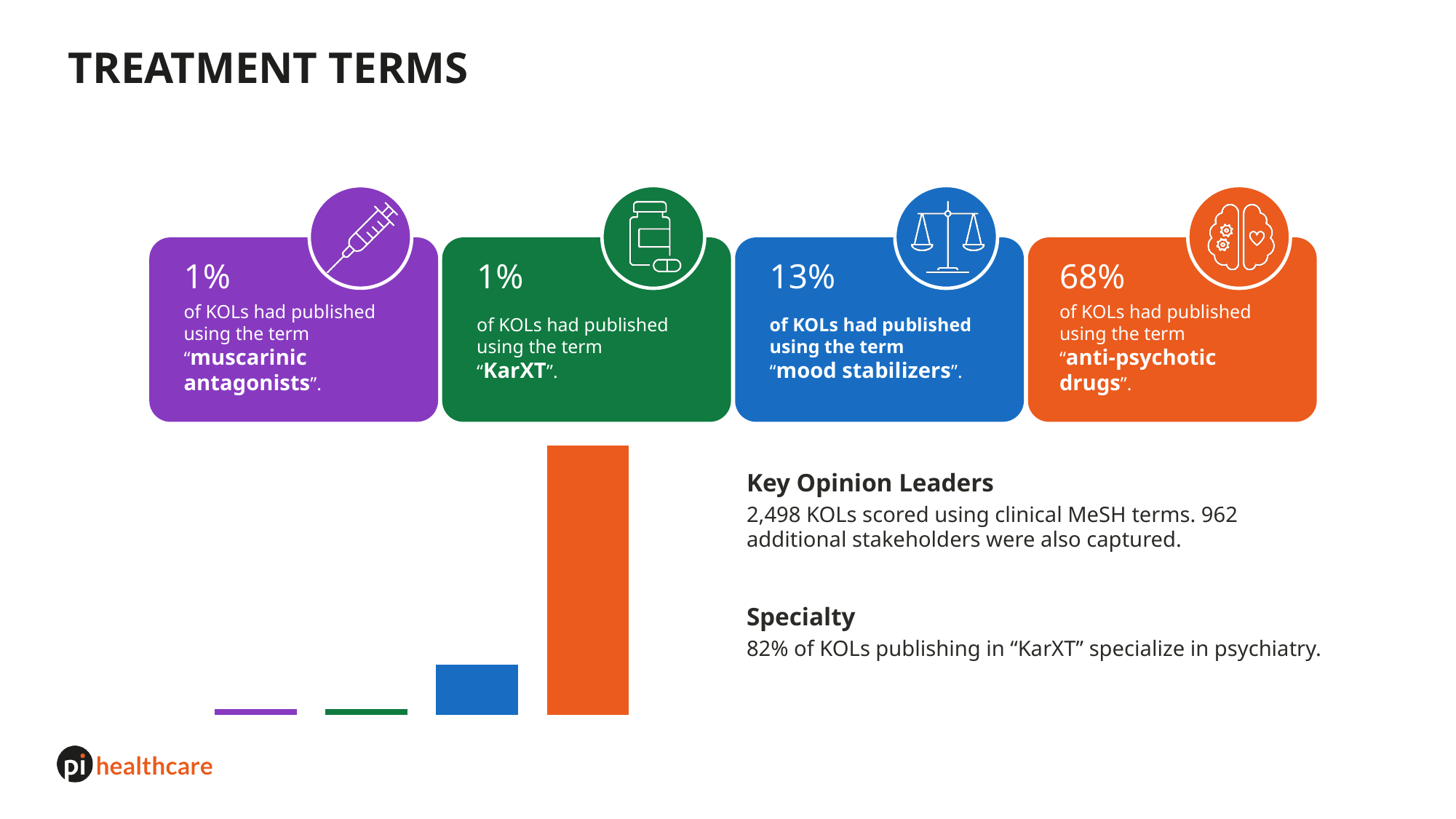
What colour is the bar representing "mood stabilizers"? blue How many bars does the chart show? 4 Do the bar values rise or fall from left to right across the chart? rise Which treatment term has the tallest bar in the chart? anti-psychotic drugs What colour is the tallest bar in the chart? orange What percentage of KOLs had published using the term "muscarinic antagonists"? 1% What percentage of KOLs had published using the term "KarXT"? 1% What percentage of KOLs had published using the term "anti-psychotic drugs"? 68% What is the difference in percentage points between the "anti-psychotic drugs" value and the "mood stabilizers" value? 55 Which is larger: the value for "mood stabilizers" or the value for "KarXT"? mood stabilizers What kind of chart is shown at the bottom of the slide? bar chart What percentage of KOLs had published using the term "mood stabilizers"? 13%